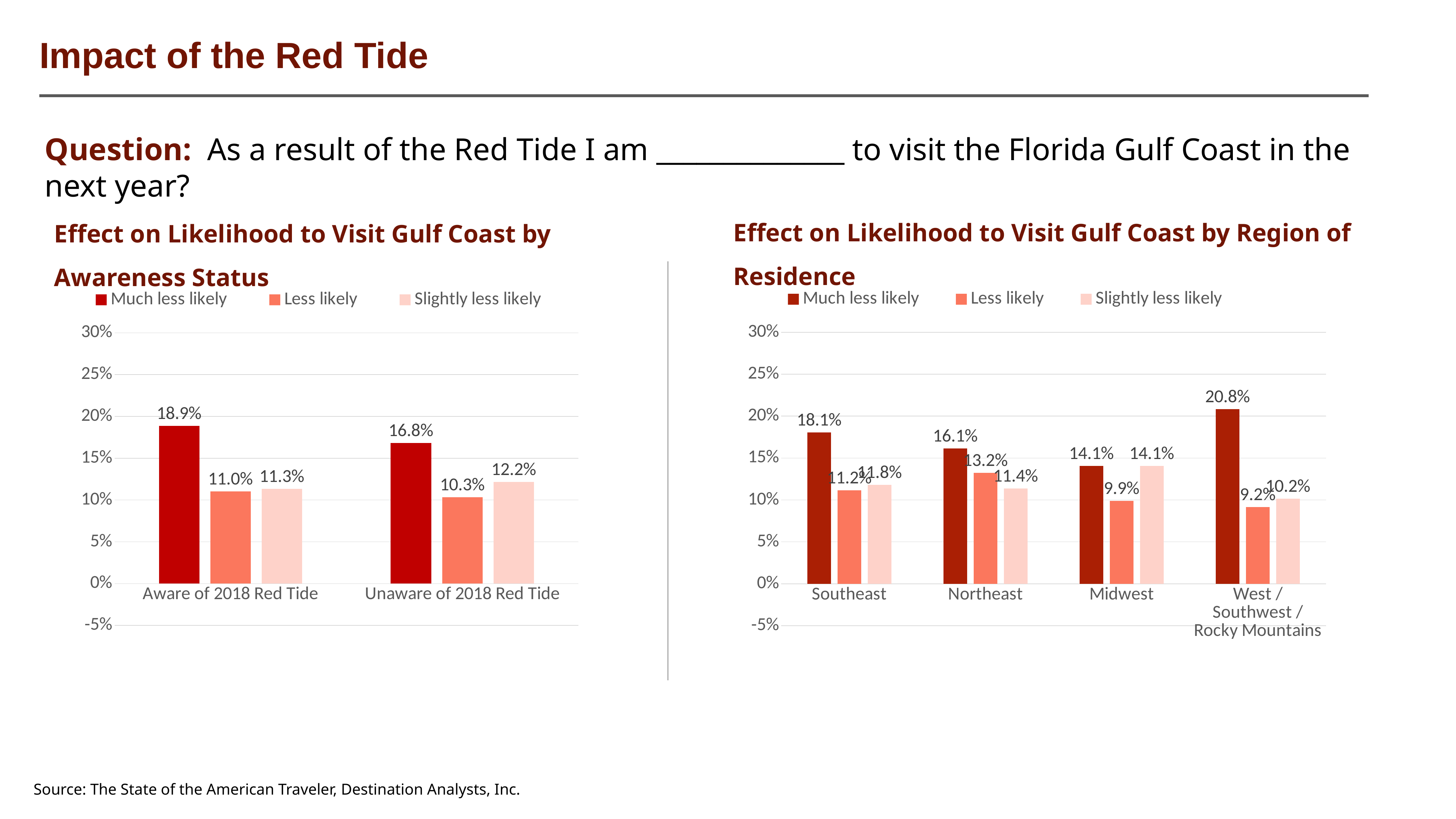
In the 'Effect on Likelihood to Visit Gulf Coast by Region of Residence' chart, is the 'Much less likely' value for Southeast or Midwest larger? Southeast In the 'Effect on Likelihood to Visit Gulf Coast by Region of Residence' chart, what is the 'Much less likely' value for West / Southwest / Rocky Mountains? 20.8% In the 'Effect on Likelihood to Visit Gulf Coast by Region of Residence' chart, which region has the lowest 'Less likely' value? West / Southwest / Rocky Mountains In the 'Effect on Likelihood to Visit Gulf Coast by Region of Residence' chart, what is the difference between the 'Much less likely' and 'Less likely' values for Midwest? 4.2% In the 'Effect on Likelihood to Visit Gulf Coast by Region of Residence' chart, how many regions are shown on the x axis? 4 In the 'Effect on Likelihood to Visit Gulf Coast by Awareness Status' chart, how many series does the legend list? 3 In the 'Effect on Likelihood to Visit Gulf Coast by Awareness Status' chart, what is the difference between the 'Much less likely' values for Aware and Unaware of 2018 Red Tide? 2.1% In the 'Effect on Likelihood to Visit Gulf Coast by Awareness Status' chart, what is the 'Slightly less likely' value for Unaware of 2018 Red Tide? 12.2% In the 'Effect on Likelihood to Visit Gulf Coast by Awareness Status' chart, what is the 'Much less likely' value for Aware of 2018 Red Tide? 18.9% In the 'Effect on Likelihood to Visit Gulf Coast by Region of Residence' chart, which region has the highest 'Much less likely' value? West / Southwest / Rocky Mountains In the 'Effect on Likelihood to Visit Gulf Coast by Region of Residence' chart, what is the 'Less likely' value for Northeast? 13.2% What kind of chart is the 'Effect on Likelihood to Visit Gulf Coast by Region of Residence' chart? Bar chart